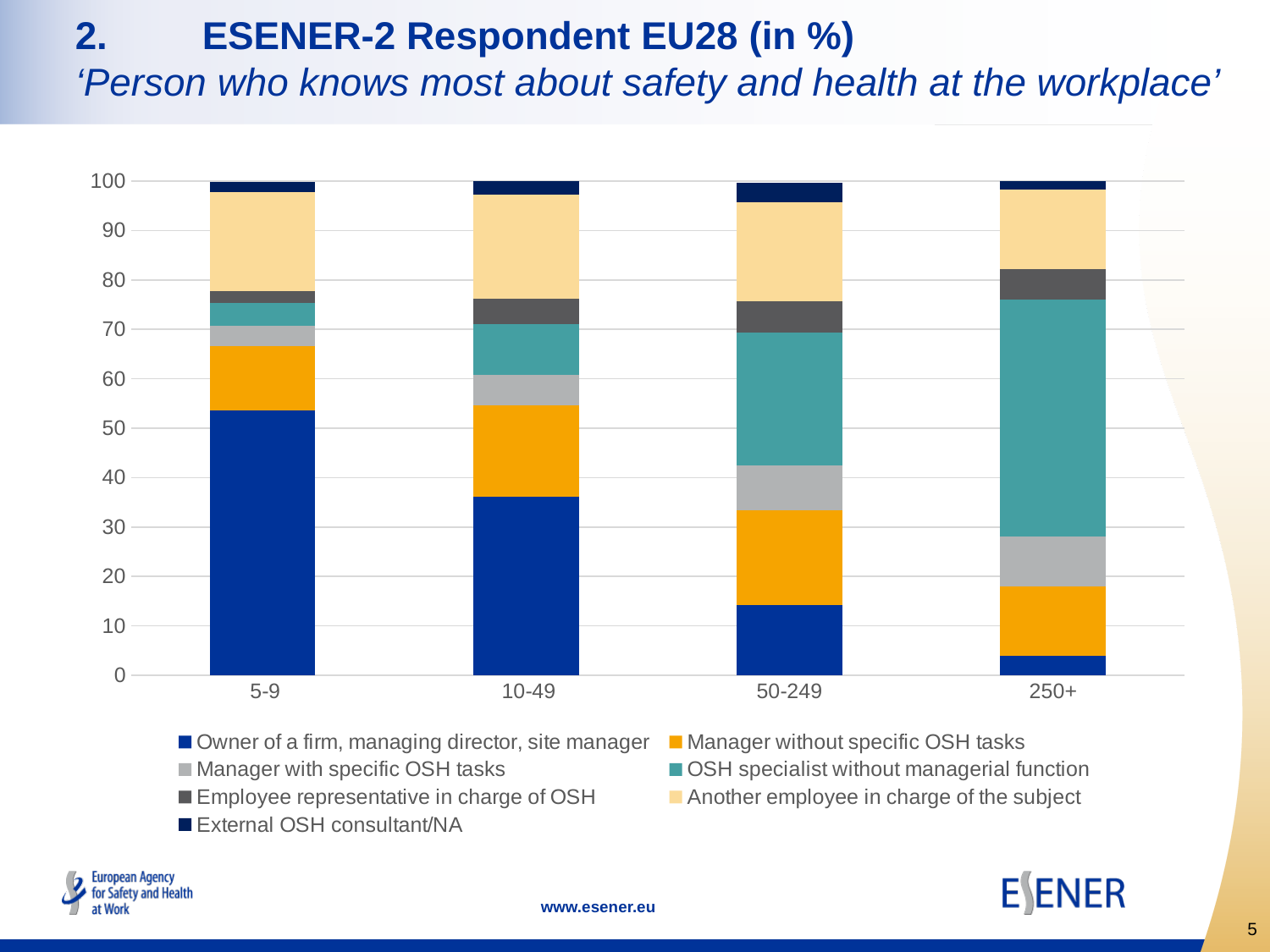
Which size category has the largest 'OSH specialist without managerial function' segment? 250+ Which legend entry is shown in dark blue at the bottom of each bar? Owner of a firm, managing director, site manager Which size category has the largest 'Owner of a firm, managing director, site manager' segment? 5-9 Is the 'Owner of a firm, managing director, site manager' value for 250+ greater or less than 10? less Which size category has the smallest 'Owner of a firm, managing director, site manager' segment? 250+ How many series does the legend list? 7 Is the 'OSH specialist without managerial function' value for 250+ greater or less than 40? greater Is the 'Owner of a firm, managing director, site manager' value for 5-9 greater or less than 50? greater What kind of chart is shown on the slide? Stacked bar chart How many establishment size categories are shown on the x axis? 4 Which is larger: the 'Owner of a firm, managing director, site manager' segment for 5-9 or for 10-49? 5-9 As establishment size increases from 5-9 to 250+, does the 'Owner of a firm, managing director, site manager' share rise or fall? Fall